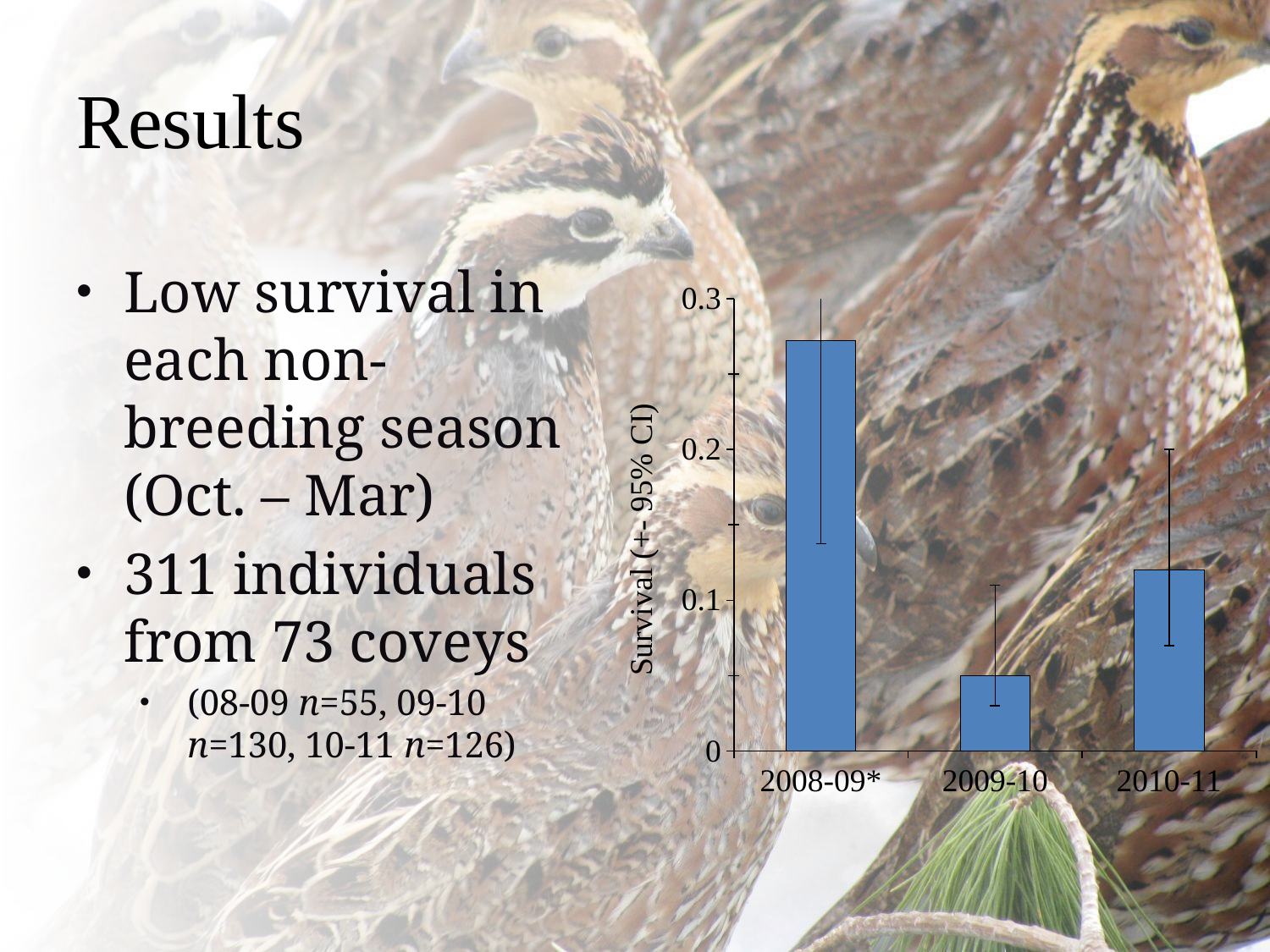
Which has the larger survival value, 2009-10 or 2010-11? 2010-11 What kind of chart is shown on the slide? bar chart Is the survival value for 2008-09* greater or less than 0.2? greater From 2008-09* to 2009-10, does the survival value rise or fall? fall Is the survival value for 2010-11 greater or less than 0.2? less How many categories (seasons) are plotted on the x axis of the chart? 3 Which has the larger survival value, 2008-09* or 2010-11? 2008-09* Is the survival value for 2009-10 greater or less than 0.1? less Which season has the lowest survival value in the chart? 2009-10 What is the label on the y axis of the chart? Survival (+- 95% CI) Which season has the highest survival value in the chart? 2008-09*